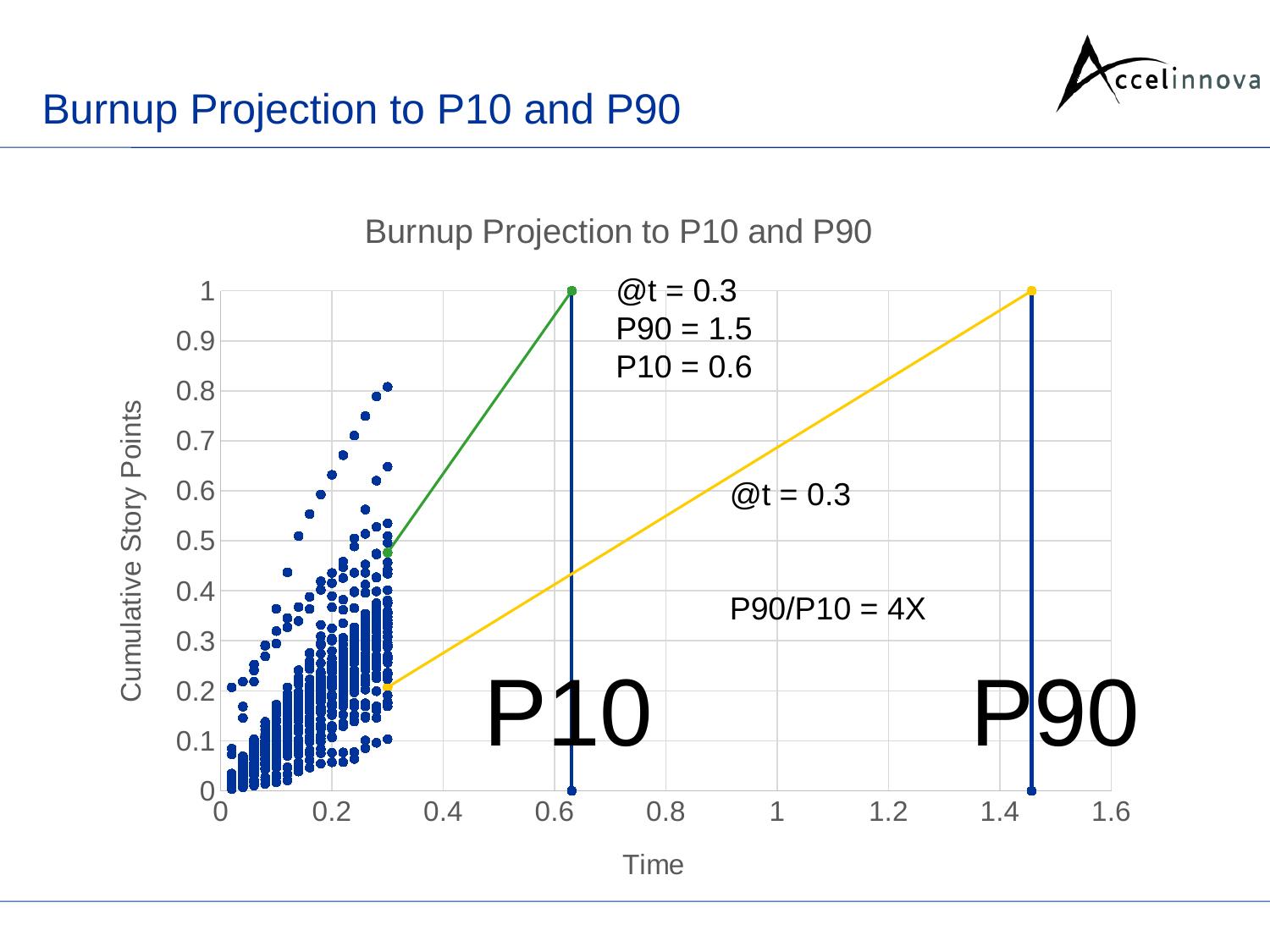
What colour is the projection line that leads to the P10 marker? green According to the annotation, what is the P10 value at t = 0.3? 0.6 What is the title of the chart? Burnup Projection to P10 and P90 What ratio of P90 to P10 is stated on the chart? 4X Is the highest blue scatter point's cumulative story points value greater or less than 0.9? less According to the annotation, what is the P90 value at t = 0.3? 1.5 What kind of chart is shown on the slide? scatter chart Is the largest time value among the blue scatter points greater or less than 0.4? less Which projection lands at a later time, P10 or P90? P90 What is the difference between the P90 and P10 values stated at t = 0.3? 0.9 Is the time at which the P90 vertical line is drawn greater or less than 1.4? greater